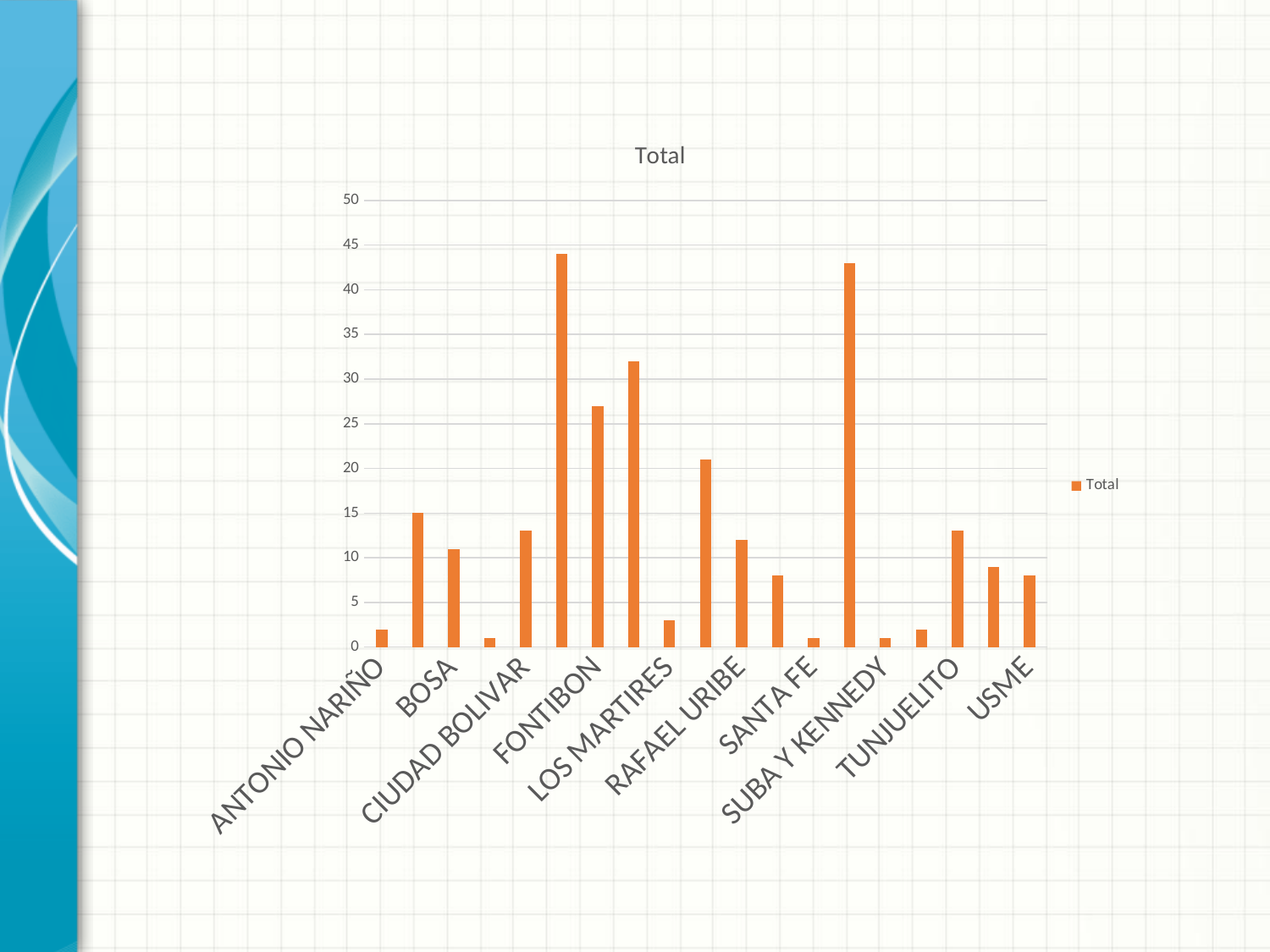
Which is larger, the value for FONTIBON or the value for BOSA? FONTIBON Which is larger, the value for USME or the value for LOS MARTIRES? USME Which is larger, the value for RAFAEL URIBE or the value for SANTA FE? RAFAEL URIBE Is the value for CIUDAD BOLIVAR greater or less than 10? greater Is the value for FONTIBON greater or less than 25? greater Is the value for RAFAEL URIBE greater or less than 15? less What kind of chart is shown on the slide? bar chart What is the title of the chart? Total How many series does the legend list? 1